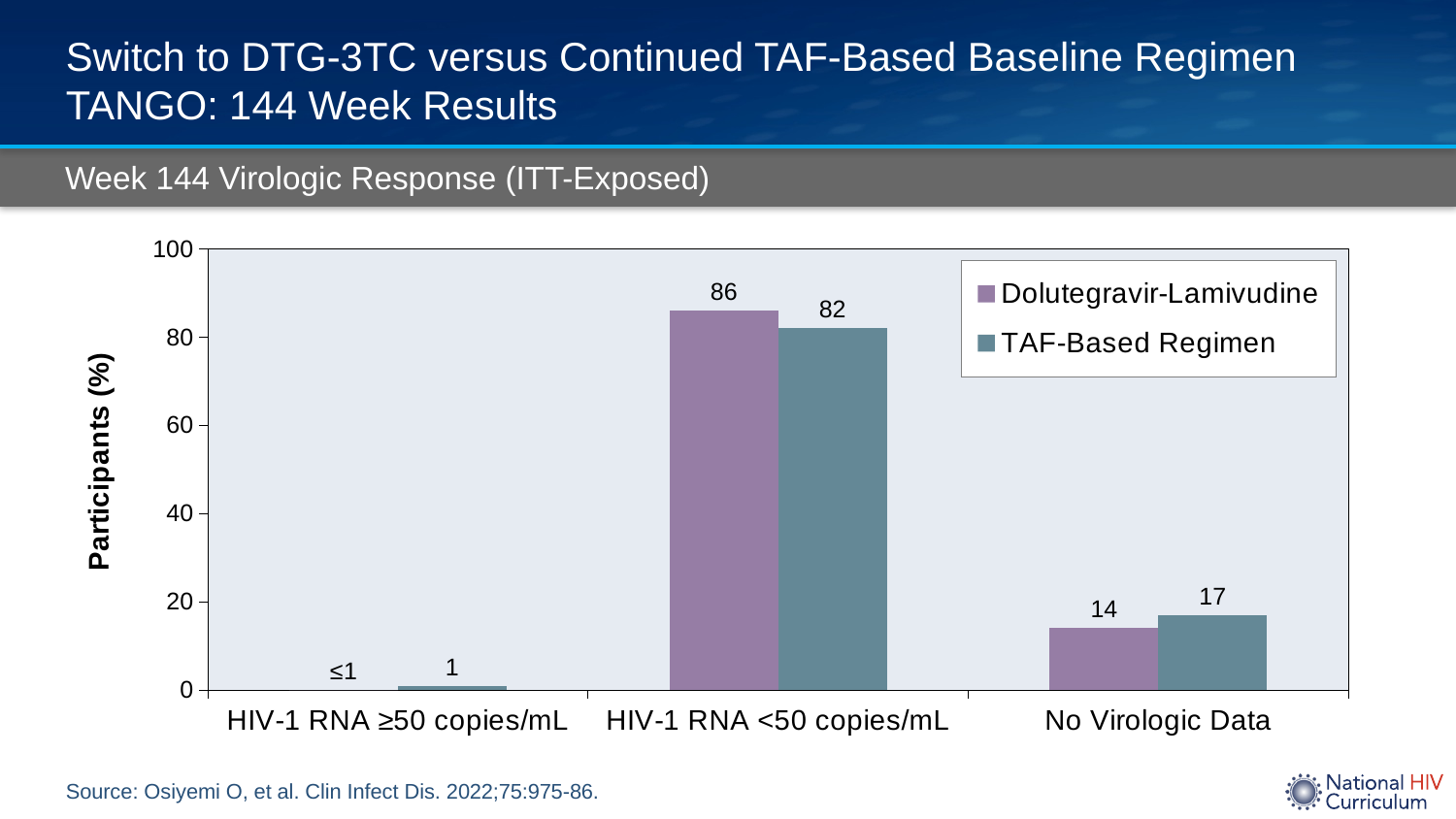
What is the value shown for HIV-1 RNA ≥50 copies/mL in the Dolutegravir-Lamivudine group? ≤1 What is the value for No Virologic Data in the TAF-Based Regimen group? 17 What is the value for HIV-1 RNA ≥50 copies/mL in the TAF-Based Regimen group? 1 What is the difference between the Dolutegravir-Lamivudine and TAF-Based Regimen values for HIV-1 RNA <50 copies/mL? 4 What percentage of participants in the Dolutegravir-Lamivudine group had HIV-1 RNA <50 copies/mL at week 144? 86 What type of chart is shown on the slide? Bar chart How many series does the legend list? 2 What percentage of participants in the TAF-Based Regimen group had HIV-1 RNA <50 copies/mL? 82 What is the value for No Virologic Data in the Dolutegravir-Lamivudine group? 14 For No Virologic Data, which group has the larger value? TAF-Based Regimen Which category has the highest value for the Dolutegravir-Lamivudine group? HIV-1 RNA <50 copies/mL How many categories are shown on the x axis? 3